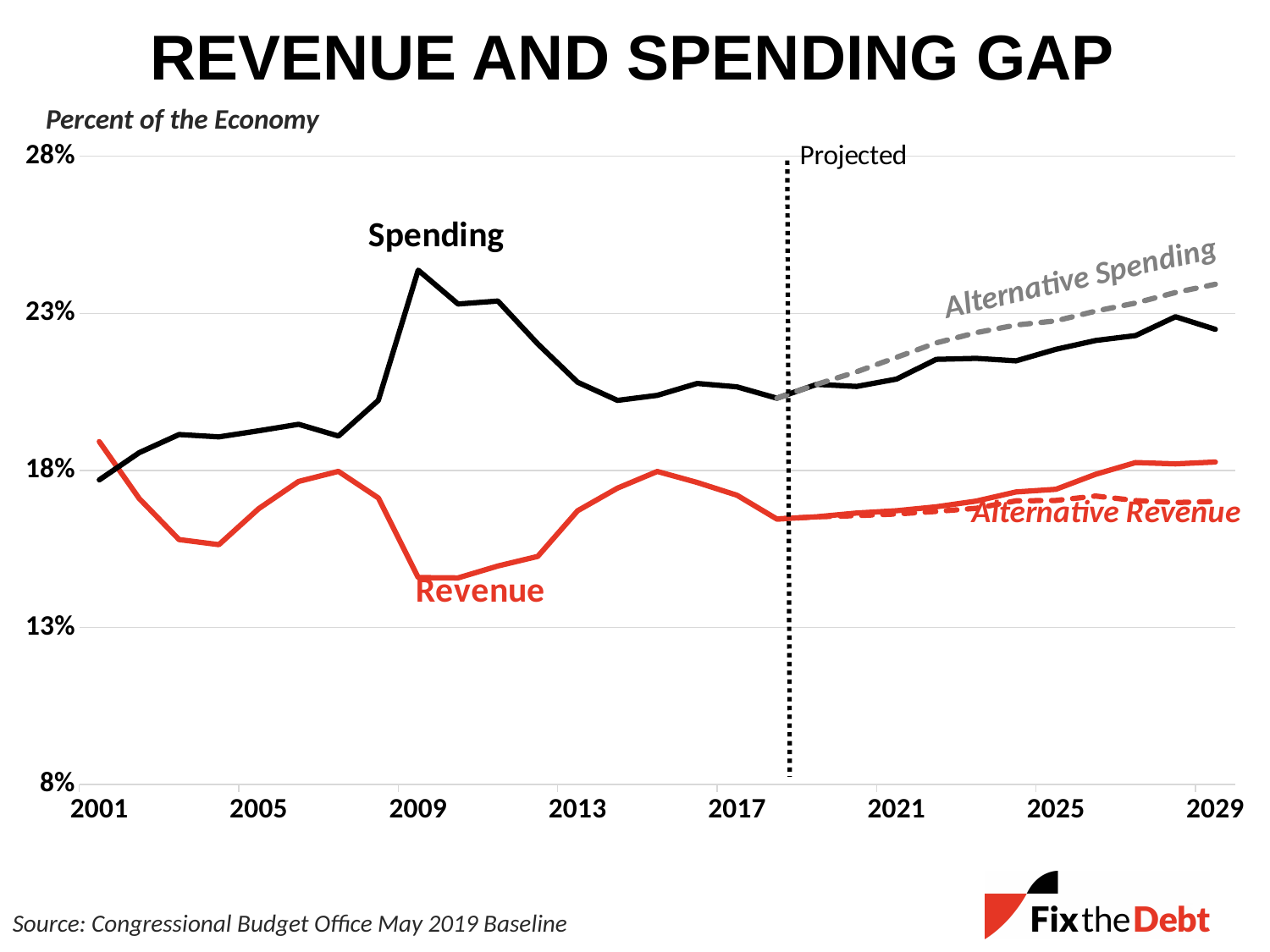
What is the title of the chart? REVENUE AND SPENDING GAP Is the value for Alternative Spending in 2029 greater or less than 23%? greater What kind of chart is shown on the slide? line chart Is the value for Spending in 2009 greater or less than 23%? greater Is the value for Revenue in 2001 greater or less than 18%? greater How many lines (series) are plotted on the chart? 4 In 2029, which line is higher: Spending or Alternative Spending? Alternative Spending Does the Alternative Spending line rise or fall from 2019 to 2029? rise In which year does the Spending line reach its highest point? 2009 What is the unit label shown above the y axis? Percent of the Economy